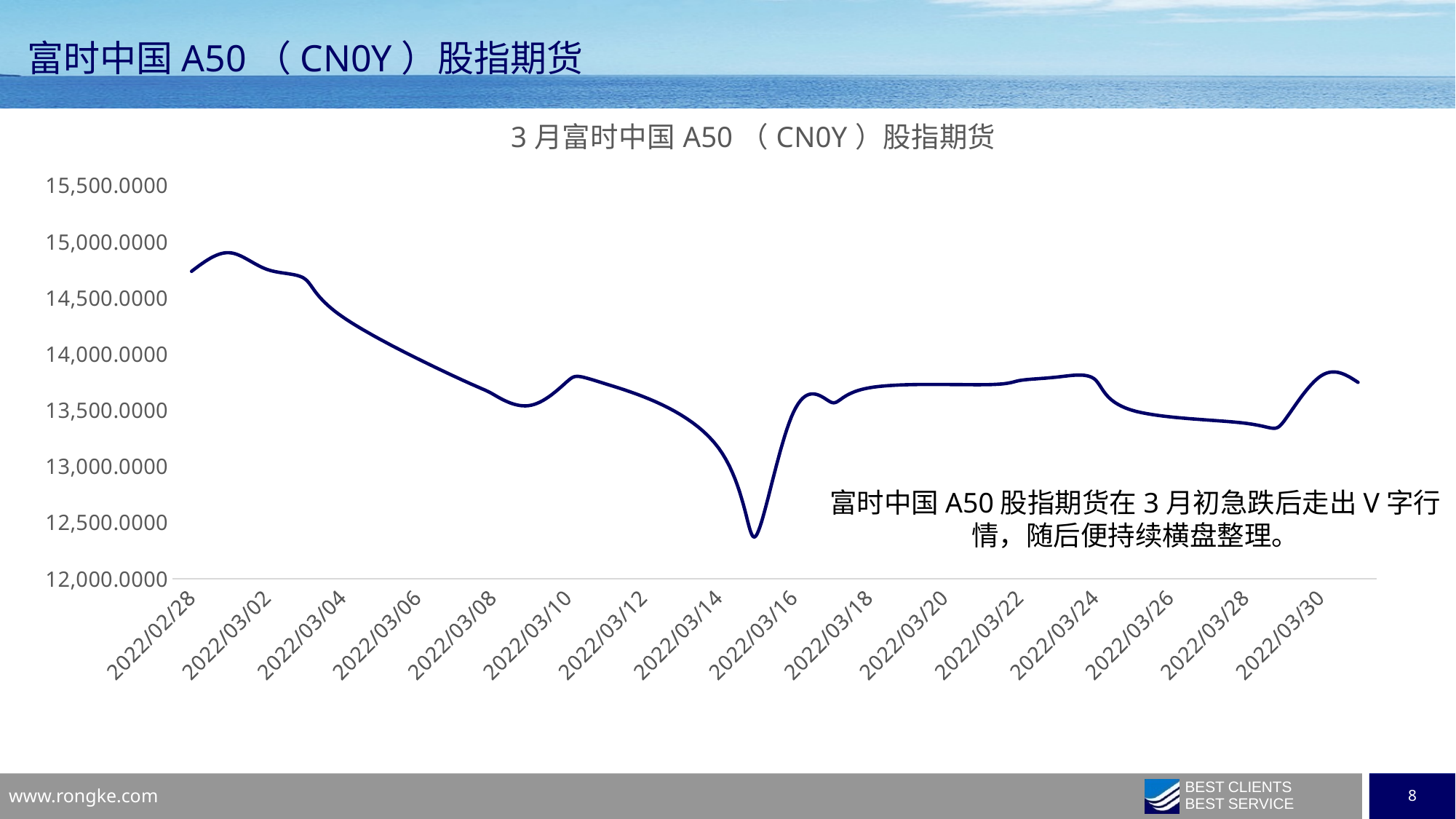
Is the value on 2022/03/20 greater or less than 13,500? greater Is the value on 2022/03/28 greater or less than 13,500? less Is the value on 2022/03/14 greater or less than 13,500? less What kind of chart is shown on the slide? line chart Overall, does the line rise or fall from the first date to the last date on the x axis? fall What is the title of the chart? 3月富时中国A50（CN0Y）股指期货 Between which two labelled dates does the line reach its lowest point? 2022/03/14 and 2022/03/16 Which is higher, the value on 2022/02/28 or the value on 2022/03/30? 2022/02/28 Between which two labelled dates does the line reach its highest point? 2022/02/28 and 2022/03/02 How many date labels are shown on the x axis? 16